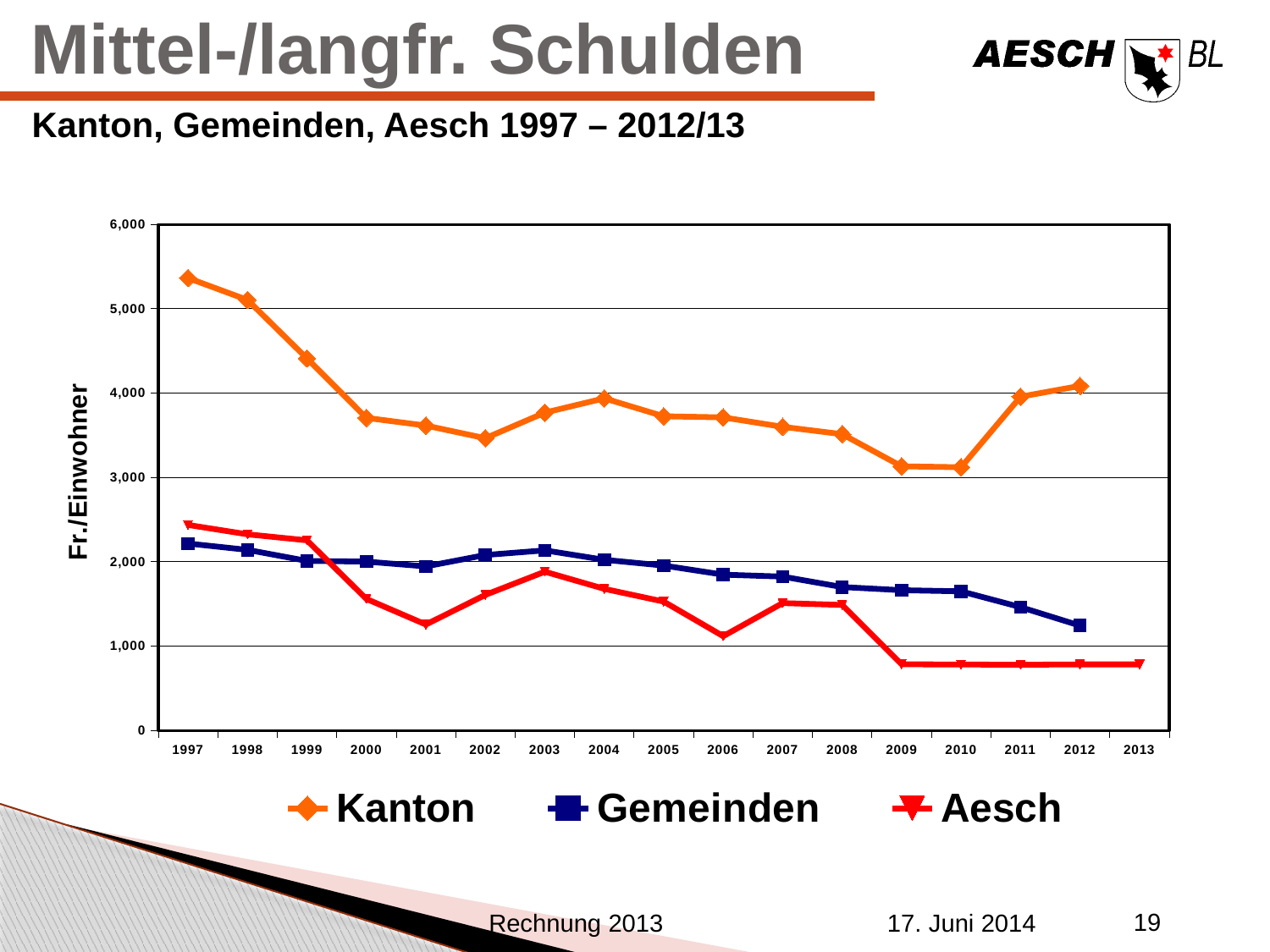
In which year is the Kanton value highest? 1997 How many years are labelled on the x axis? 17 What kind of chart is shown on the slide? line chart Which series has the highest values across the whole chart? Kanton Is the Gemeinden value for 1997 greater or less than 2,000? greater In which year is the Gemeinden value lowest? 2012 How many series does the legend list? 3 Is the Kanton value for 2000 greater or less than 4,000? less Is the Kanton value for 1997 greater or less than 5,000? greater What is the label on the y axis? Fr./Einwohner In 2001, which is larger: the Gemeinden value or the Aesch value? Gemeinden